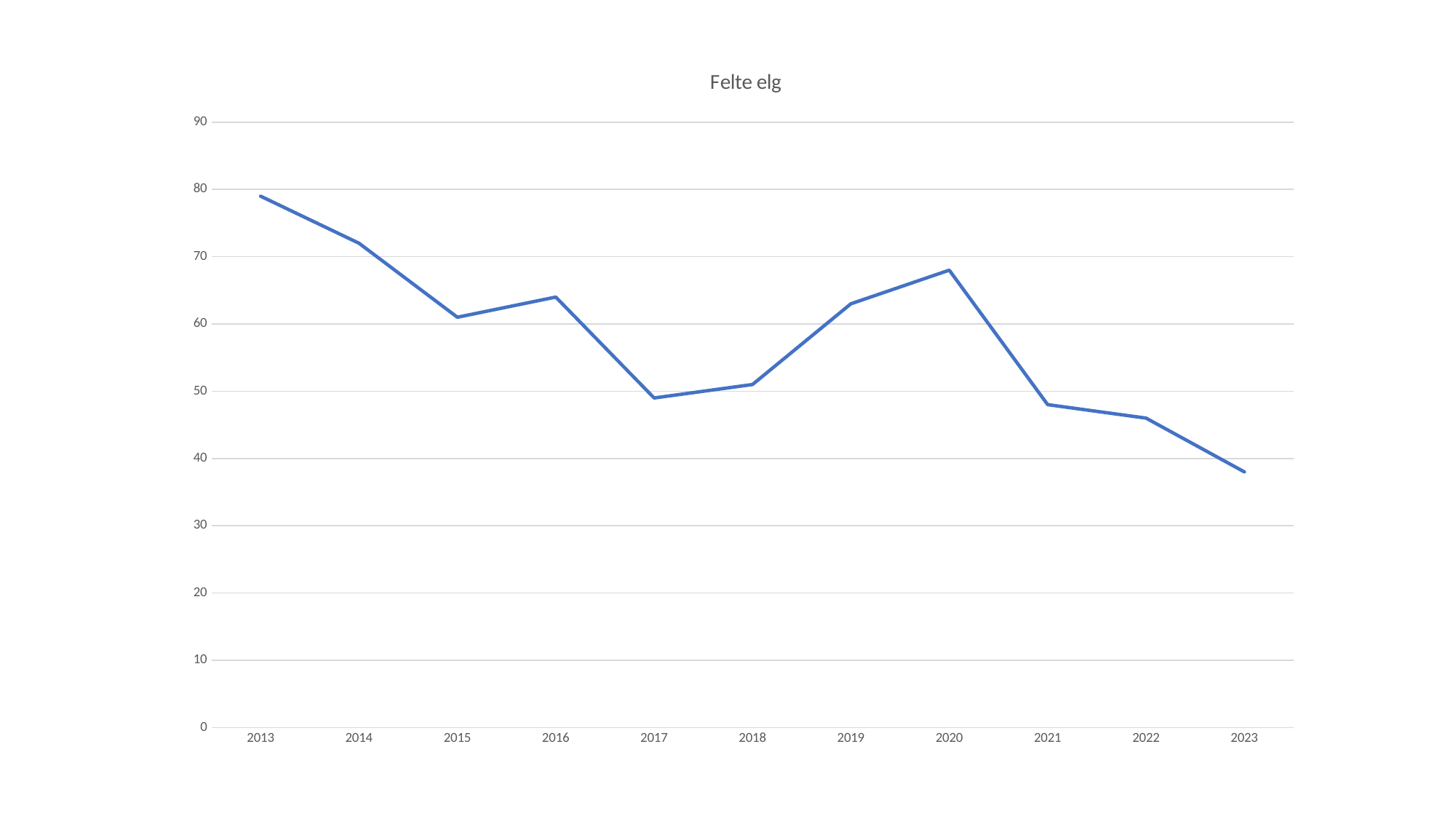
Which year has the larger value, 2014 or 2015? 2014 What kind of chart is shown on the slide? line chart Is the value for 2023 greater or less than 40? less What is the title of the chart? Felte elg Which year has the larger value, 2019 or 2020? 2020 Overall, do the values rise or fall from 2013 to 2023? fall Is the value for 2013 greater or less than 70? greater How many years are plotted on the x axis? 11 Is the value for 2020 greater or less than 60? greater Which year has the lowest value? 2023 Which year has the highest value? 2013